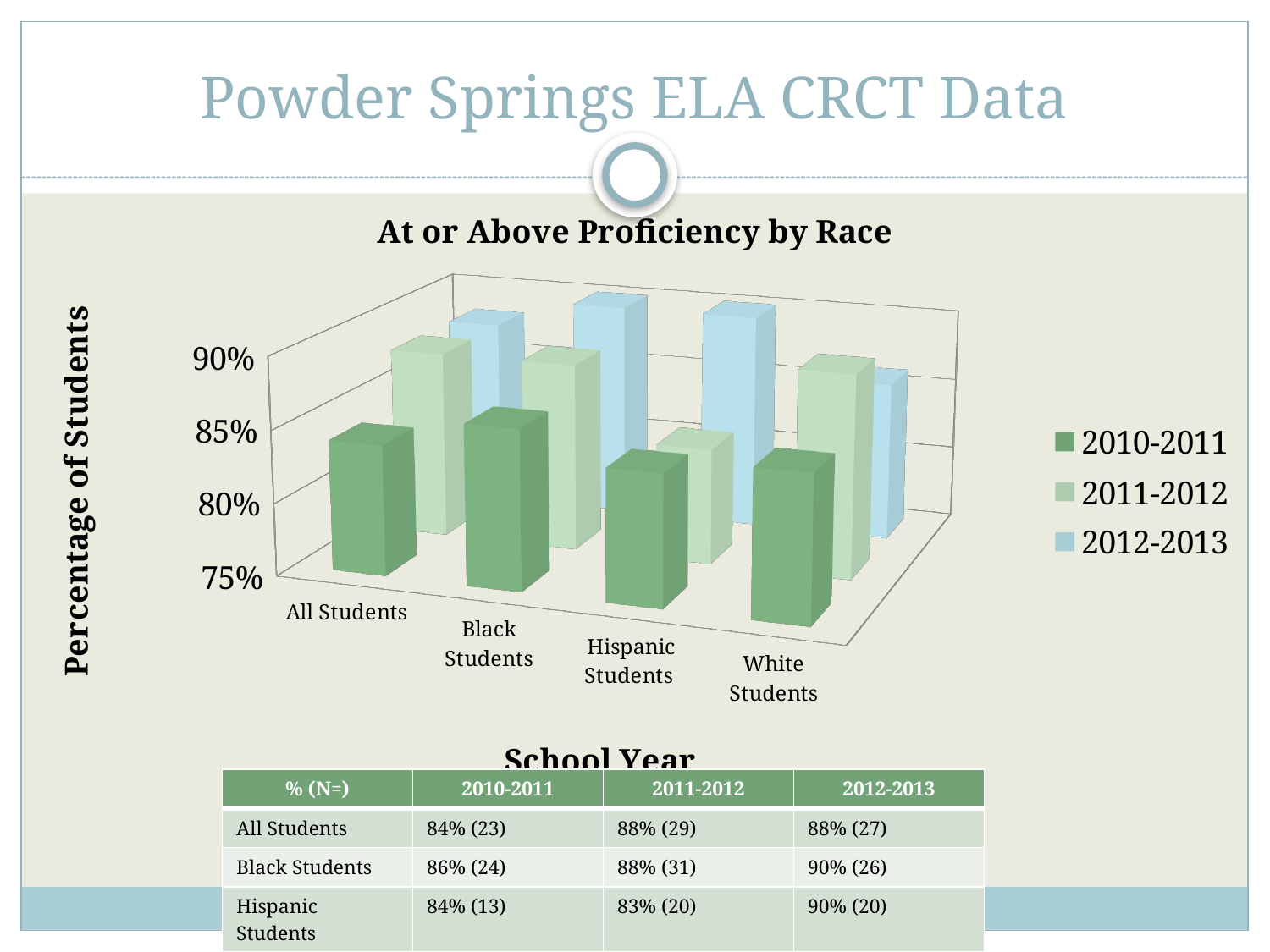
By how many percentage points did the Black Students value increase from 2010-2011 to 2012-2013? 4 What percentage of Hispanic Students were at or above proficiency in 2011-2012? 83% How many series does the legend list? 3 What is the label on the vertical axis of the chart? Percentage of Students What kind of chart is shown on the slide? bar chart What is the title of the chart? At or Above Proficiency by Race How many student groups are shown along the x axis of the chart? 4 Do the values for Black Students rise or fall from 2010-2011 to 2012-2013? rise For Hispanic Students, which school year has the lowest percentage at or above proficiency? 2011-2012 What percentage of All Students were at or above proficiency in 2010-2011? 84% What percentage of Black Students were at or above proficiency in 2012-2013? 90% For Black Students, which school year has the highest percentage at or above proficiency? 2012-2013